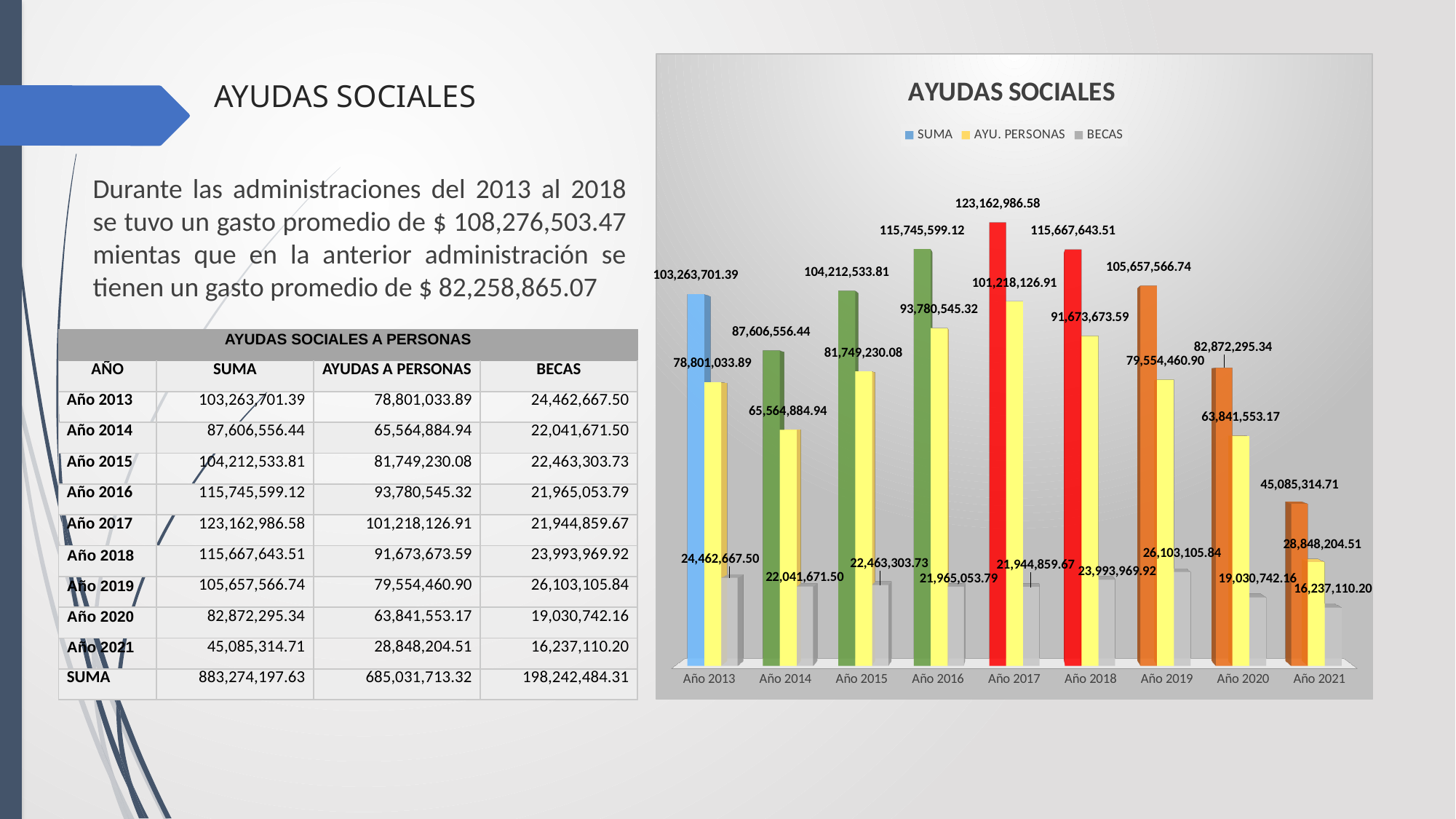
How many series does the chart legend list? 3 How many years are shown on the x axis of the chart? 9 What is the AYU. PERSONAS value for Año 2020? 63,841,553.17 What is the SUMA value for Año 2017? 123,162,986.58 Which year has the larger AYU. PERSONAS value, Año 2016 or Año 2018? Año 2016 Which year has the lowest BECAS value? Año 2021 What is the BECAS value for Año 2019? 26,103,105.84 Does the SUMA value rise or fall from Año 2018 to Año 2021? Fall What is the difference between the SUMA values for Año 2017 and Año 2018? 7,495,343.07 What kind of chart is shown on the slide? Bar chart Which year has the highest SUMA value? Año 2017 Which year has the lowest SUMA value? Año 2021